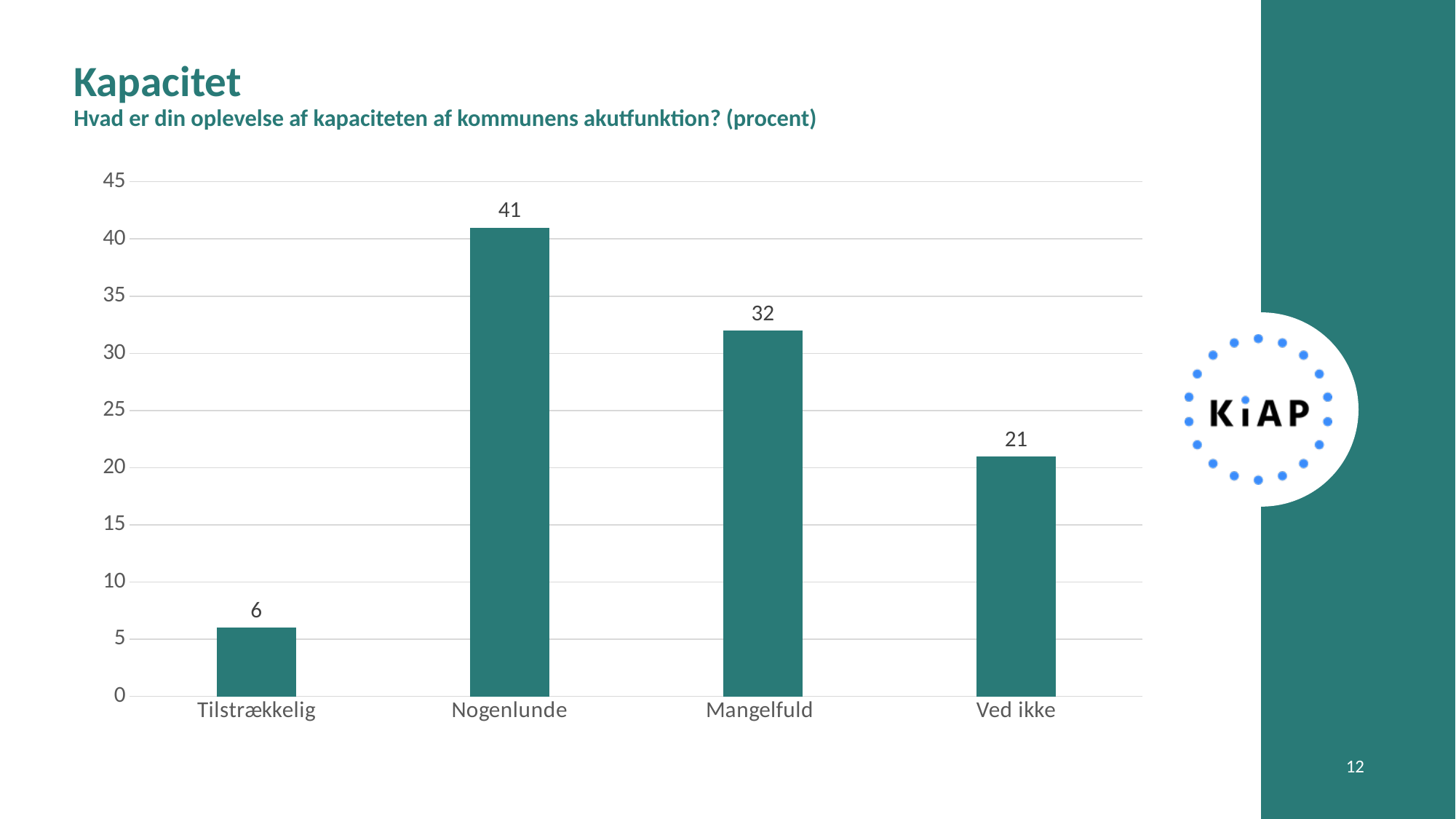
What is the value for Nogenlunde? 41 Which is larger, the value for Mangelfuld or the value for Ved ikke? Mangelfuld Which category has the highest value? Nogenlunde What is the value for Ved ikke? 21 Which category has the lowest value? Tilstrækkelig What is the difference between the values for Ved ikke and Tilstrækkelig? 15 How many categories are shown on the x axis? 4 Is the value for Mangelfuld greater or less than 30? greater What is the difference between the values for Nogenlunde and Mangelfuld? 9 What is the value for Tilstrækkelig? 6 What is the highest value shown on the y axis? 45 What kind of chart is shown on the slide? Bar chart